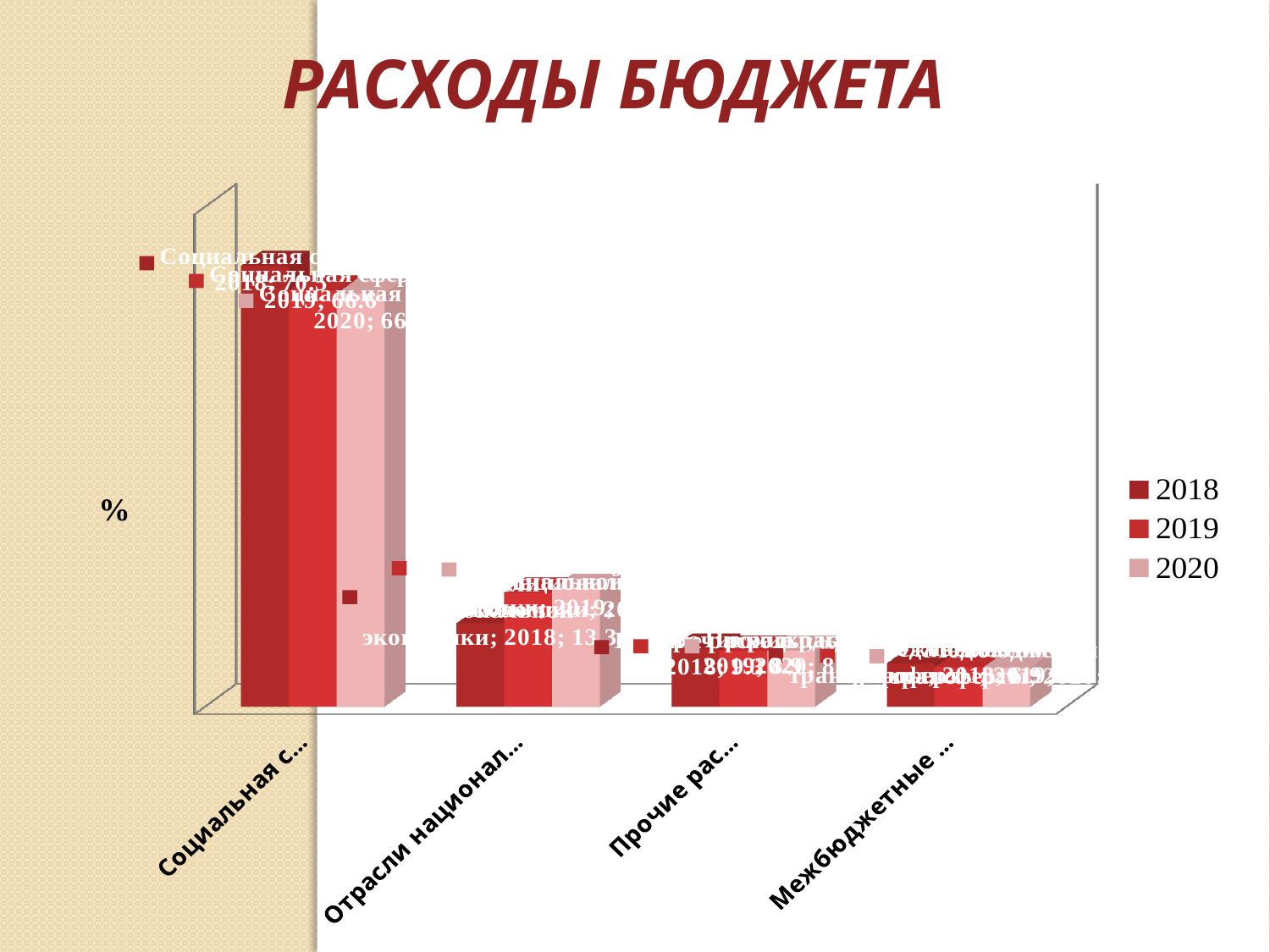
Which category has the lowest values in the chart? Межбюджетные трансферты Which category has the highest values in the chart? Социальная сфера What kind of chart is shown on the slide? bar chart Which is larger for 2018: the value for Социальная сфера or the value for Отрасли национальной экономики? Социальная сфера Do the values rise or fall moving from left to right along the x axis? fall How many series does the legend list? 3 What unit is shown on the vertical axis label of the chart? % What is the title of the slide containing the chart? РАСХОДЫ БЮДЖЕТА What is the value for Социальная сфера in 2019? 66.6 Which is larger for 2020: the value for Прочие расходы or the value for Межбюджетные трансферты? Прочие расходы Which years are listed in the chart legend? 2018, 2019, 2020 How many categories are shown on the x axis of the chart? 4